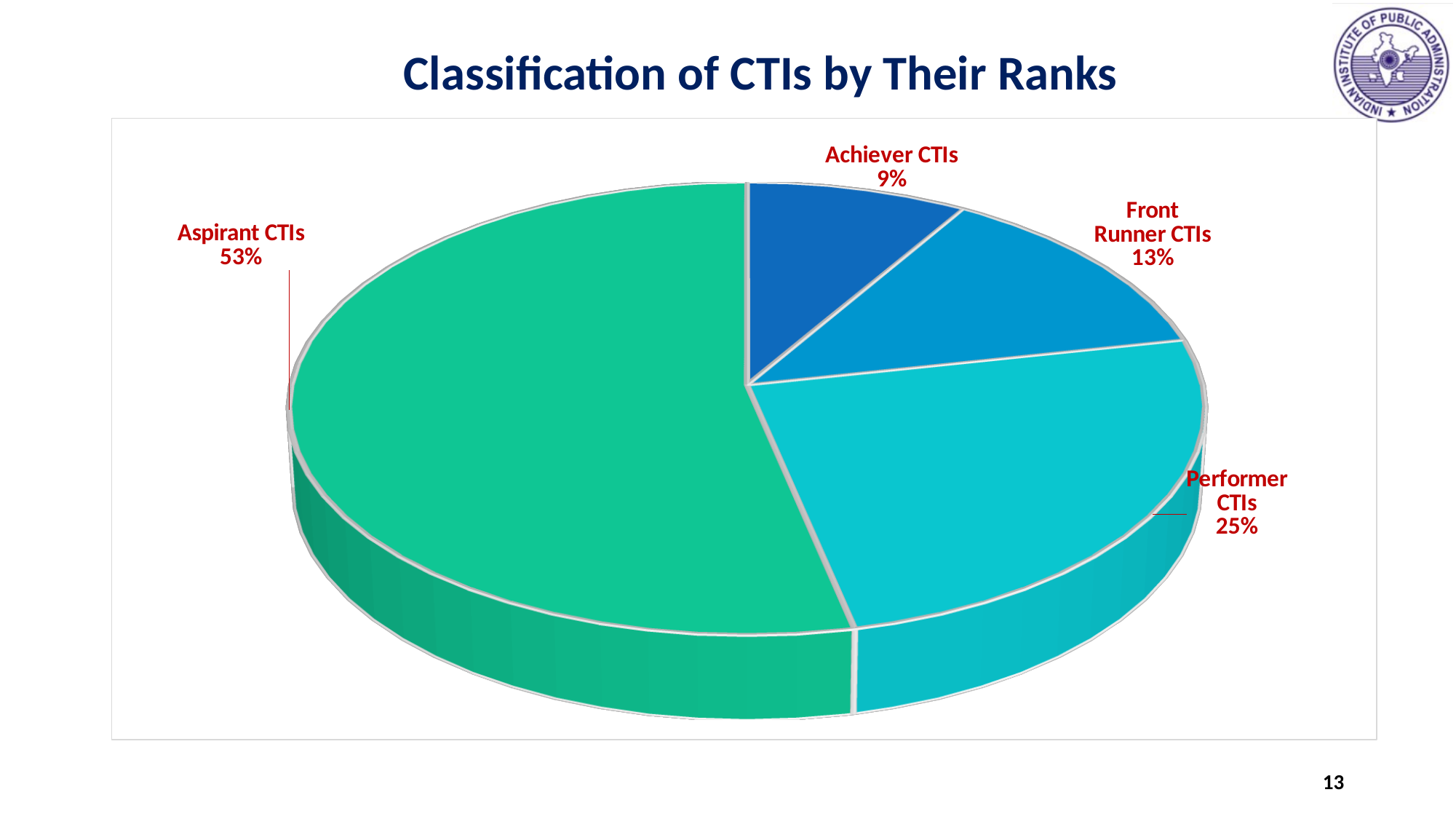
Which category has the largest share of CTIs? Aspirant CTIs What kind of chart is shown on the slide? Pie chart What share of CTIs are Achiever CTIs? 9% What is the difference in percentage points between Aspirant CTIs and Performer CTIs? 28 Which category has the smallest share of CTIs? Achiever CTIs What is the title of the chart? Classification of CTIs by Their Ranks What share of CTIs are Aspirant CTIs? 53% How many categories does the pie chart show? 4 What share of CTIs are Front Runner CTIs? 13% What share of CTIs are Performer CTIs? 25% Which is larger, the share of Performer CTIs or the share of Front Runner CTIs? Performer CTIs What is the difference in percentage points between Front Runner CTIs and Achiever CTIs? 4